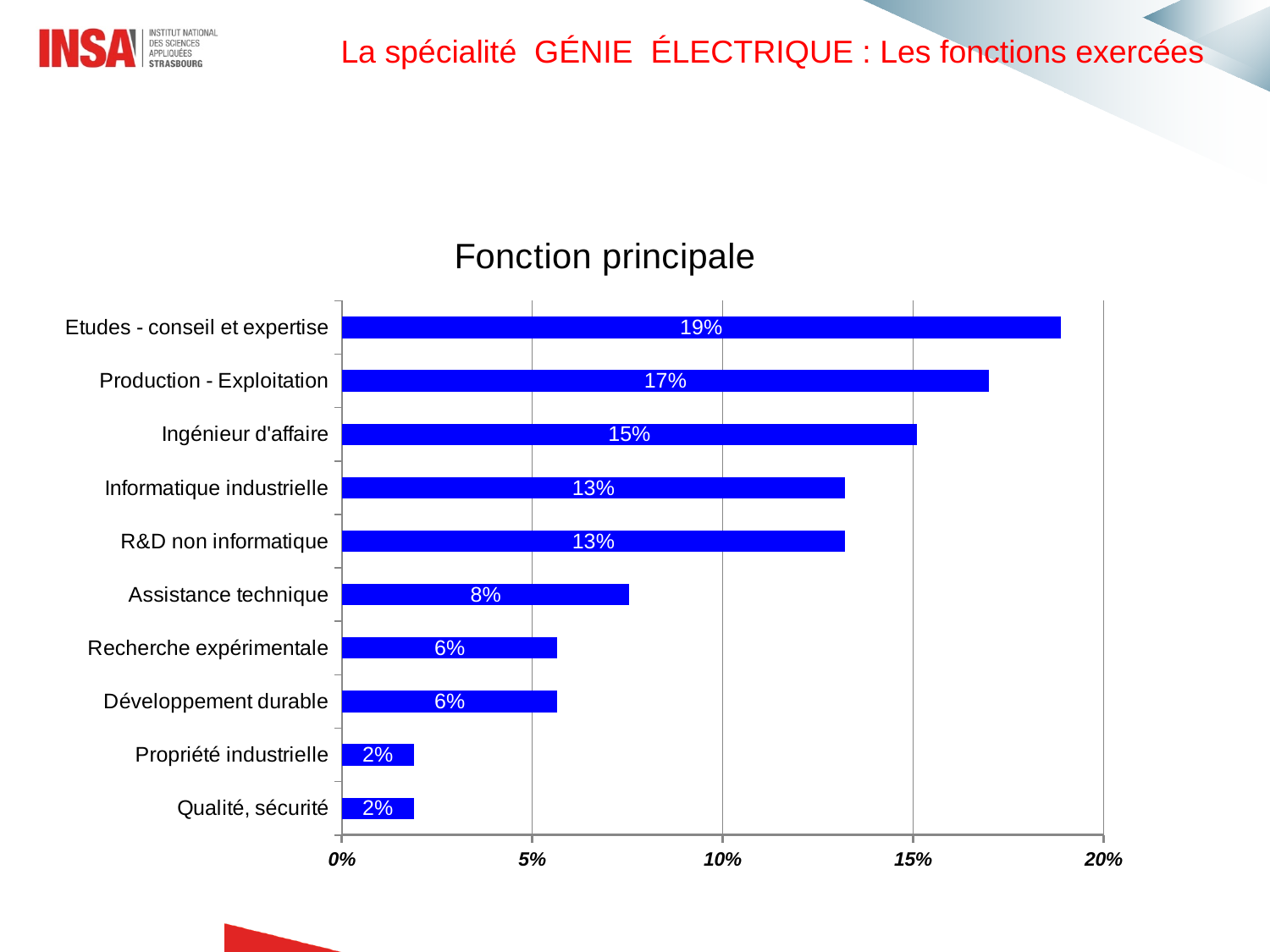
What is the value for Développement durable? 6% Which is larger, Informatique industrielle or Assistance technique? Informatique industrielle Is the value for Production - Exploitation greater or less than 15%? greater How many categories are shown in the chart? 10 What kind of chart is shown on the slide? Bar chart What is the value for Etudes - conseil et expertise? 19% What is the value for Assistance technique? 8% What is the value for Ingénieur d'affaire? 15% What is the difference between Production - Exploitation and Recherche expérimentale? 11% What is the title of the chart? Fonction principale What is the difference between Etudes - conseil et expertise and Qualité, sécurité? 17% Which category has the highest value? Etudes - conseil et expertise